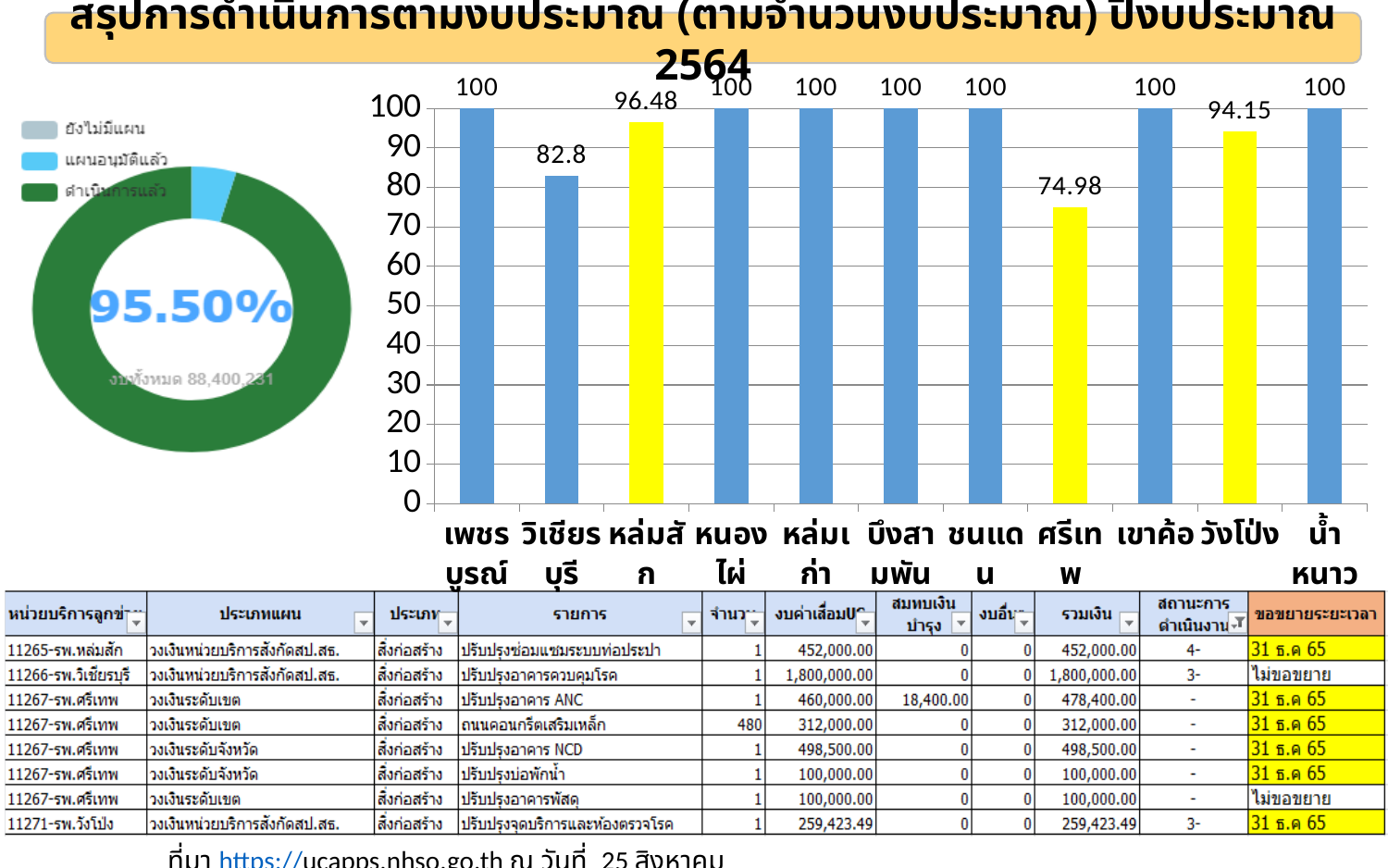
How many entries does the legend of the donut chart on the left list? 3 What percentage is shown in the centre of the donut chart on the left? 95.50% In the bar chart, how many categories are shown on the x axis? 11 In the bar chart, what is the value for วังโป่ง? 94.15 In the bar chart, what is the difference between the values for หล่มสัก and ศรีเทพ? 21.5 In the bar chart, what is the value for วิเชียรบุรี? 82.8 In the bar chart, what is the value for หล่มสัก? 96.48 In the bar chart, which is larger, the value for วิเชียรบุรี or the value for วังโป่ง? วังโป่ง In the bar chart, how many categories have a value of 100? 7 What kind of chart is the chart on the right side of the slide? bar chart In the bar chart, what is the value for ศรีเทพ? 74.98 In the bar chart, which category has the lowest value? ศรีเทพ